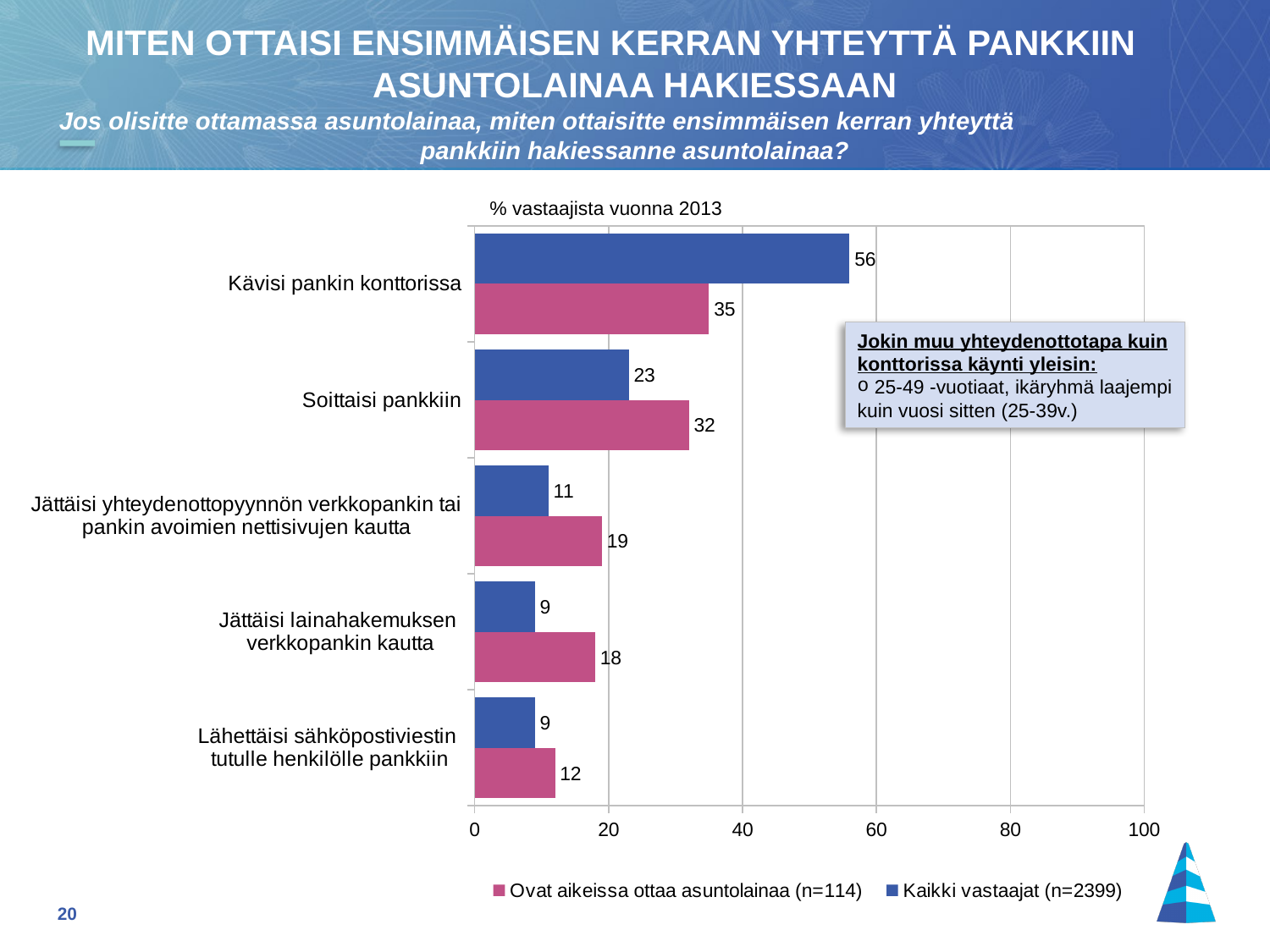
What is the axis label shown above the chart? % vastaajista vuonna 2013 How many categories are shown on the chart? 5 For 'Soittaisi pankkiin', which series has the larger value: 'Kaikki vastaajat (n=2399)' or 'Ovat aikeissa ottaa asuntolainaa (n=114)'? Ovat aikeissa ottaa asuntolainaa (n=114) Which category has the lowest value in the 'Ovat aikeissa ottaa asuntolainaa (n=114)' series? Lähettäisi sähköpostiviestin tutulle henkilölle pankkiin What is the value for 'Soittaisi pankkiin' in the 'Ovat aikeissa ottaa asuntolainaa (n=114)' series? 32 Which category has the highest value in the 'Kaikki vastaajat (n=2399)' series? Kävisi pankin konttorissa What is the difference between the 'Kaikki vastaajat (n=2399)' and 'Ovat aikeissa ottaa asuntolainaa (n=114)' values for 'Kävisi pankin konttorissa'? 21 What is the value for 'Lähettäisi sähköpostiviestin tutulle henkilölle pankkiin' in the 'Ovat aikeissa ottaa asuntolainaa (n=114)' series? 12 What is the value for 'Kävisi pankin konttorissa' in the 'Kaikki vastaajat (n=2399)' series? 56 What kind of chart is shown on the slide? Bar chart How many series does the legend list? 2 Is the value for 'Kävisi pankin konttorissa' in the 'Kaikki vastaajat (n=2399)' series greater or less than 40? greater